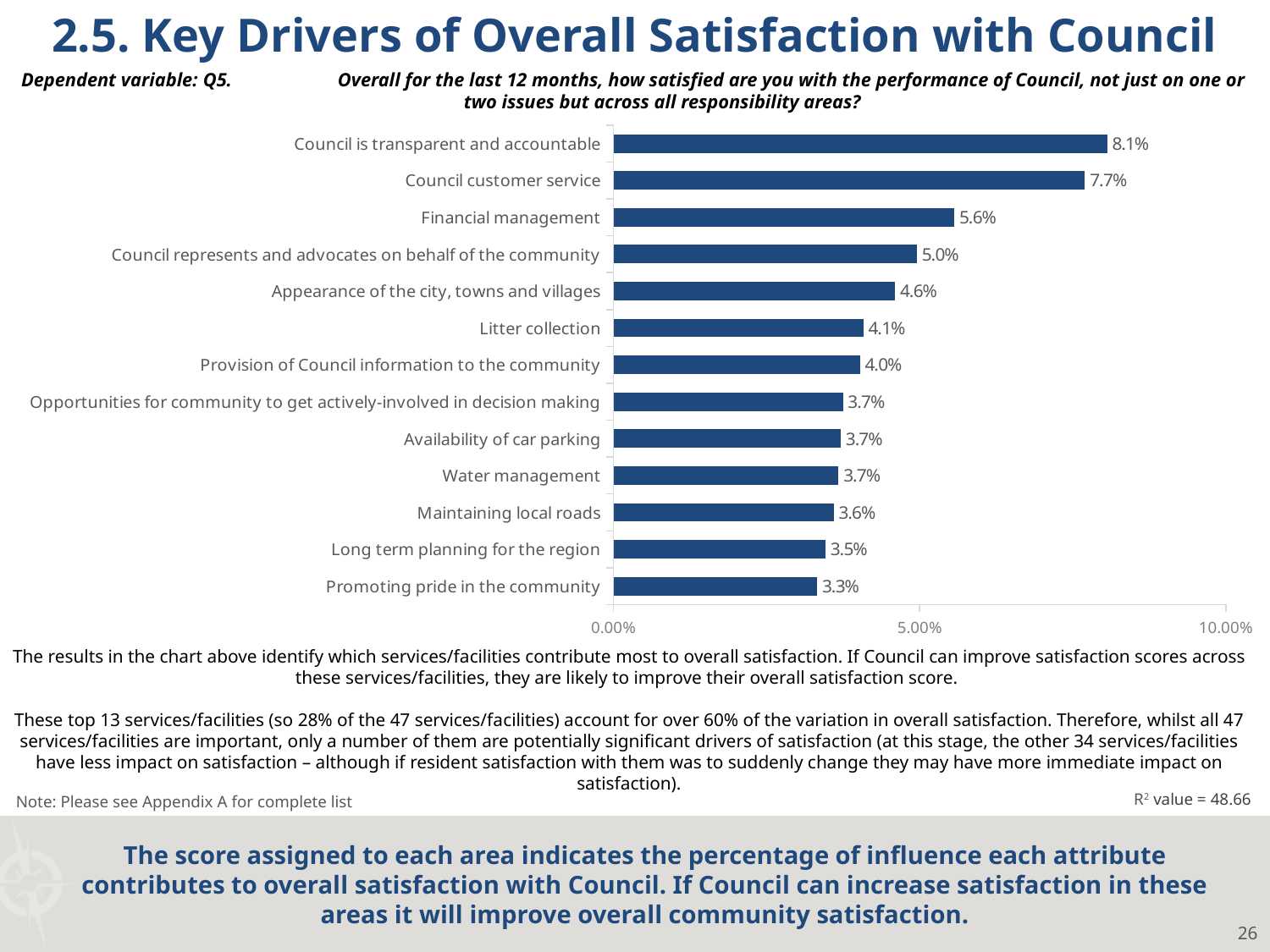
Which category has the highest value? Council is transparent and accountable What is the difference between Council is transparent and accountable and Council customer service? 0.4% What is the value for Litter collection? 4.1% Which category has the lowest value? Promoting pride in the community What is the value for Council is transparent and accountable? 8.1% What is the value for Promoting pride in the community? 3.3% What is the difference between Financial management and Promoting pride in the community? 2.3% How many categories are shown in the chart? 13 What kind of chart is shown on the slide? bar chart What is the value for Financial management? 5.6% Which is larger, Appearance of the city, towns and villages or Maintaining local roads? Appearance of the city, towns and villages Is the value for Council customer service greater or less than 5.00%? greater